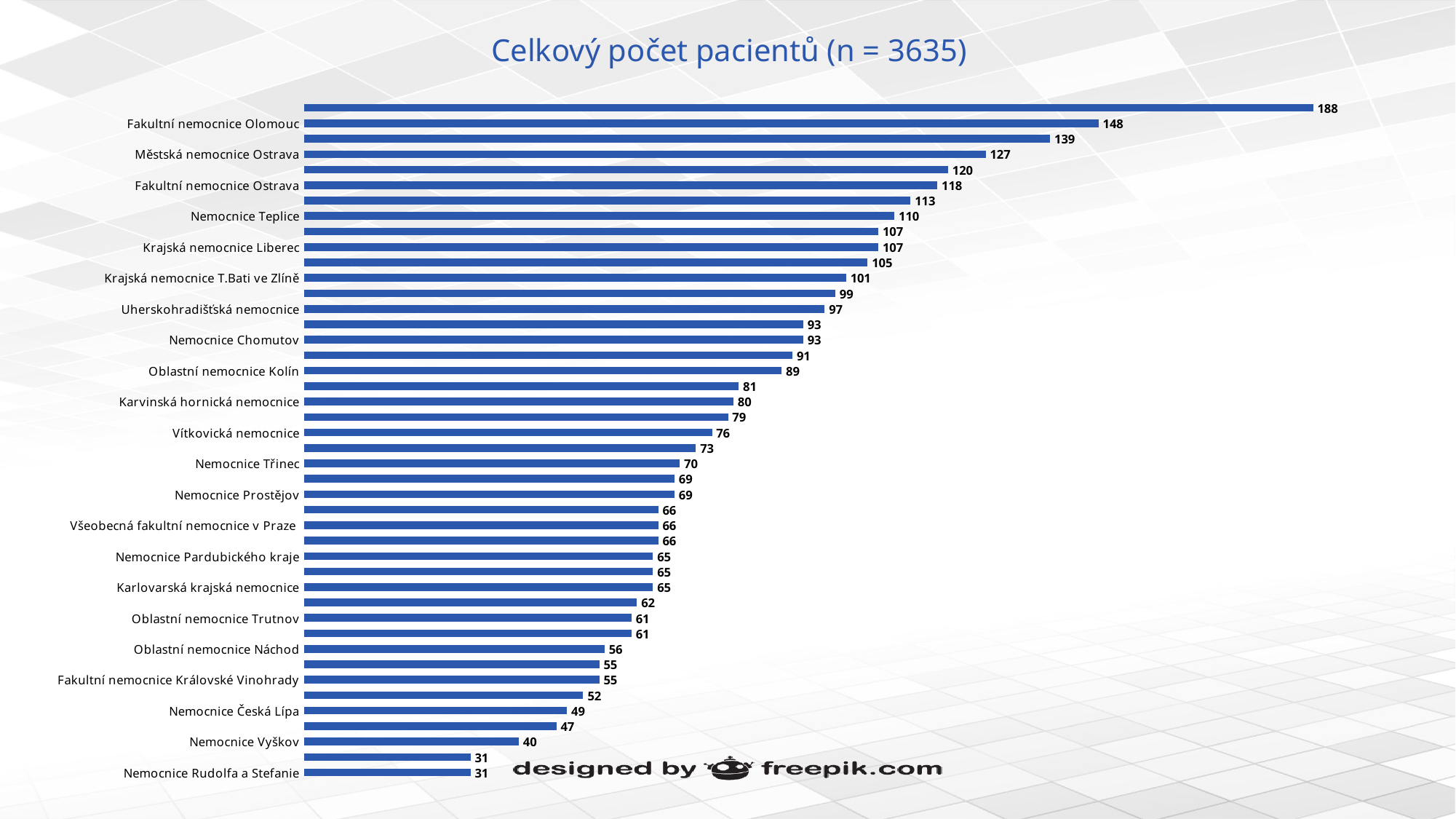
What is the difference between the values for Fakultní nemocnice Olomouc and Nemocnice Rudolfa a Stefanie? 117 Which has a larger value, Krajská nemocnice Liberec or Nemocnice Chomutov? Krajská nemocnice Liberec What is the value for Fakultní nemocnice Královské Vinohrady? 55 What kind of chart is shown on the slide? bar chart What is the value for Fakultní nemocnice Olomouc? 148 What is the value for Nemocnice Vyškov? 40 What is the value for Nemocnice Teplice? 110 What is the highest value shown on the chart? 188 Which has a larger value, Nemocnice Česká Lípa or Oblastní nemocnice Náchod? Oblastní nemocnice Náchod What is the difference between the values for Městská nemocnice Ostrava and Fakultní nemocnice Ostrava? 9 What is the title of the chart? Celkový počet pacientů (n = 3635) What is the value for Oblastní nemocnice Kolín? 89